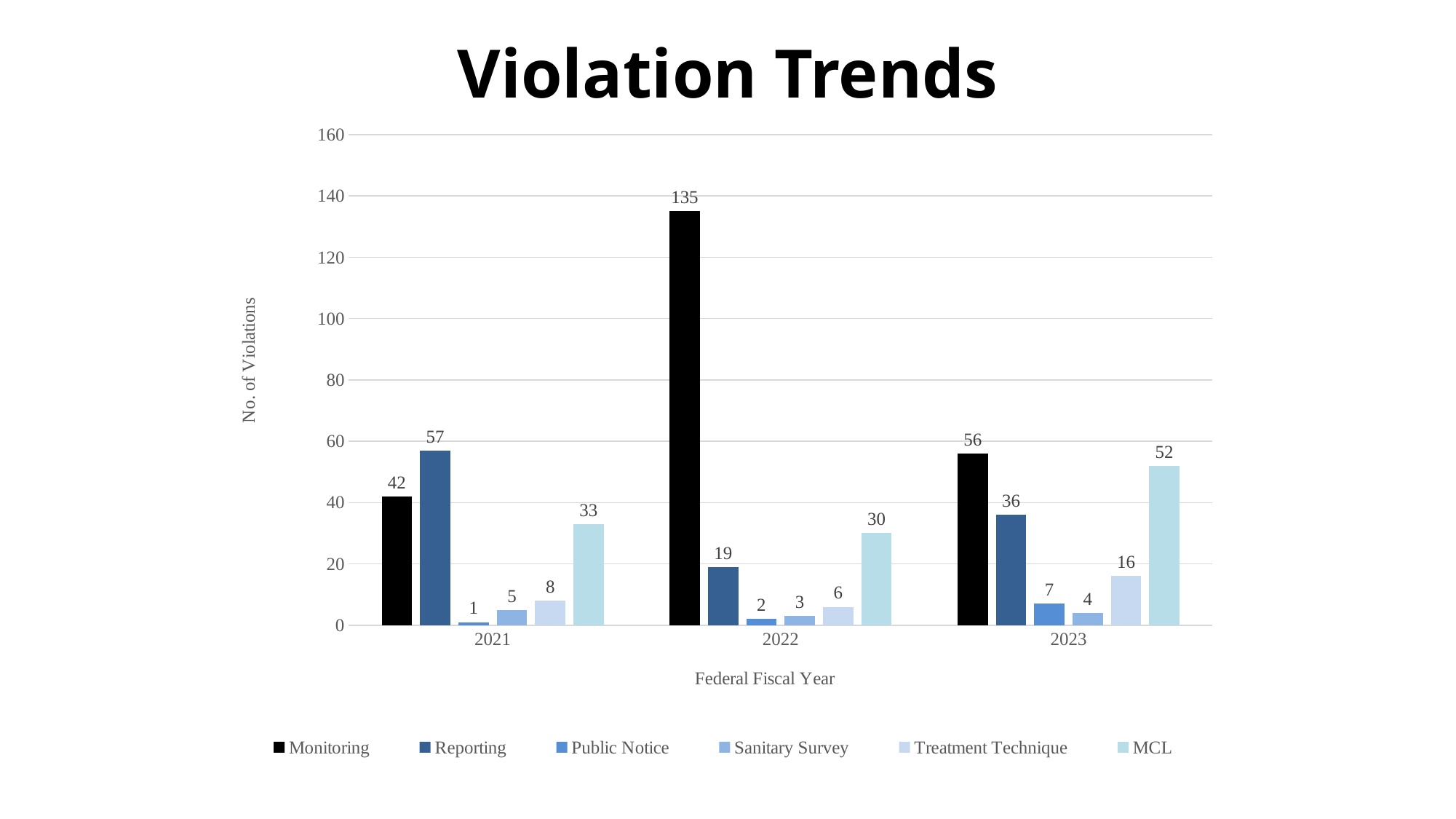
What is the number of Reporting violations in 2021? 57 What is the difference between Monitoring violations in 2022 and 2023? 79 What kind of chart is shown on the slide? Bar chart How many series does the legend list? 6 What is the label of the y axis? No. of Violations How many fiscal years are shown on the x axis? 3 Which year has the lowest number of Public Notice violations? 2021 Which is larger in 2023: Reporting violations or MCL violations? MCL What is the number of Monitoring violations in 2022? 135 Is the value for Monitoring in 2022 greater or less than 120? greater What is the number of MCL violations in 2023? 52 Which year has the highest number of Monitoring violations? 2022